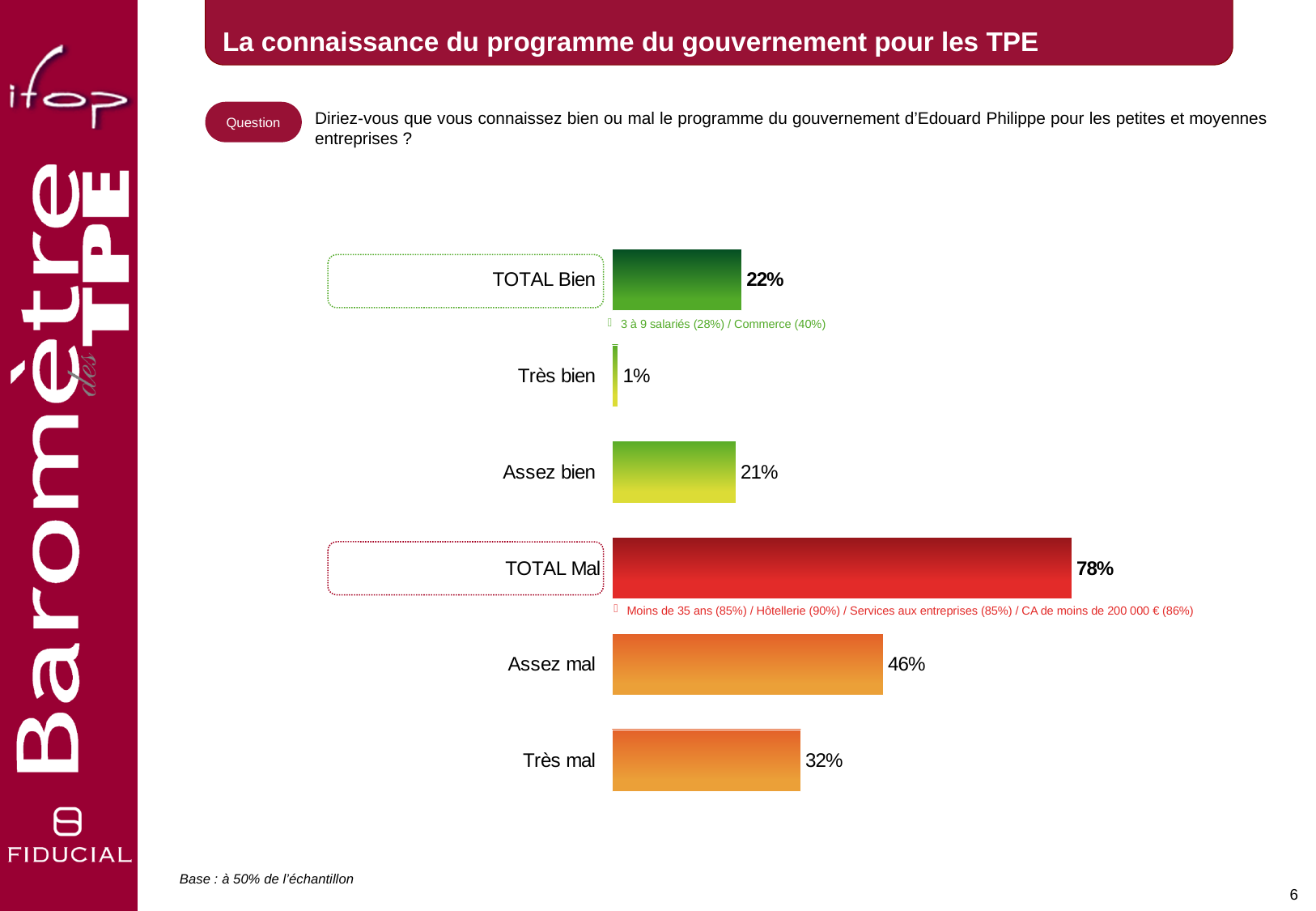
What kind of chart is shown on the slide? Bar chart What is the value for Assez bien? 21% Which category has the highest value? TOTAL Mal What is the value for Très bien? 1% What is the difference between TOTAL Mal and TOTAL Bien? 56% What is the value for Très mal? 32% How many categories are shown in the chart? 6 Which category has the lowest value? Très bien Which is larger, Assez mal or Très mal? Assez mal What is the value for Assez mal? 46% What is the value for TOTAL Mal? 78% What is the value for TOTAL Bien? 22%